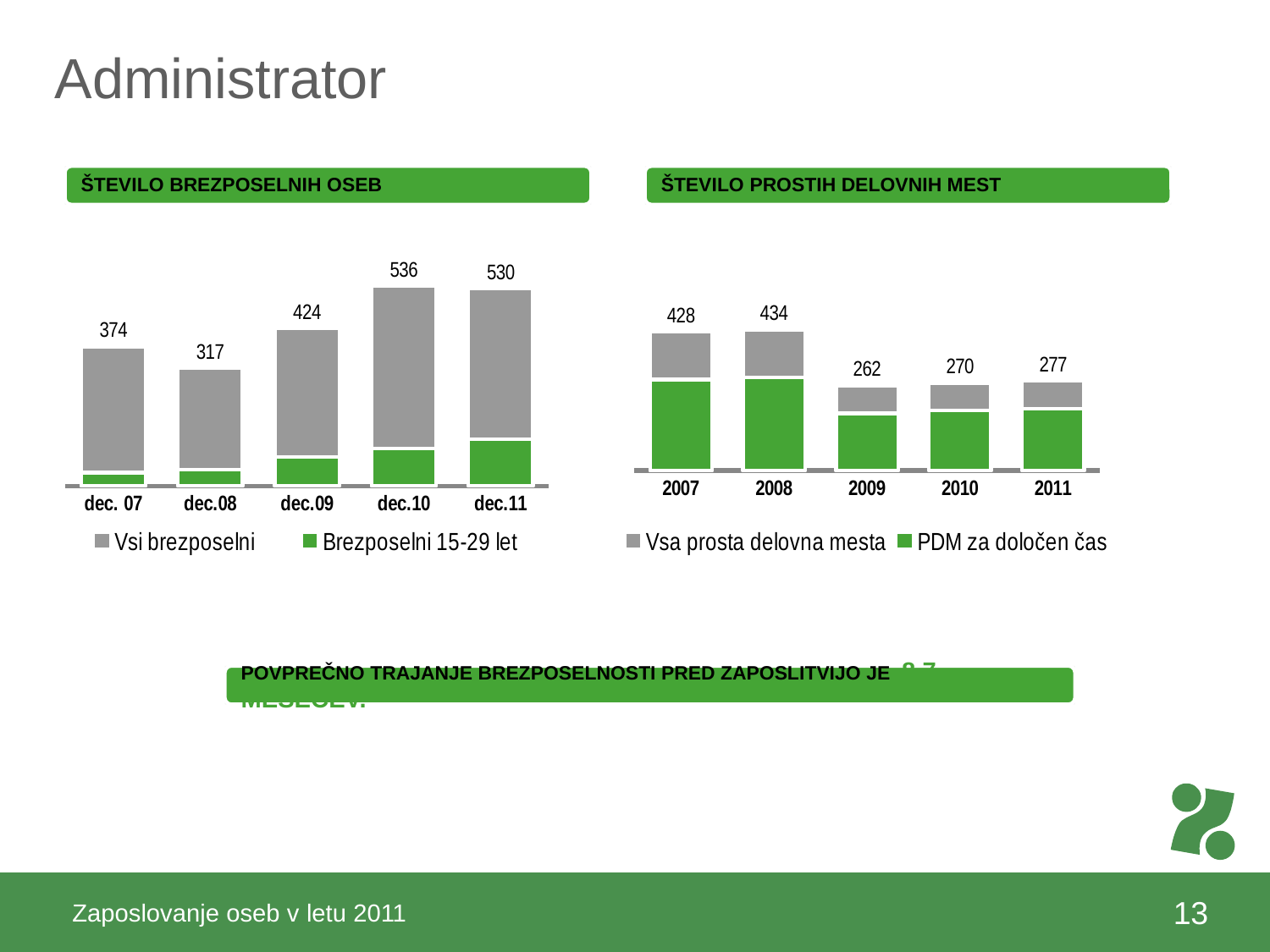
In the chart titled ŠTEVILO BREZPOSELNIH OSEB, what value is labelled for dec.10? 536 In the chart titled ŠTEVILO PROSTIH DELOVNIH MEST, which year has the lowest labelled value? 2009 In the chart titled ŠTEVILO PROSTIH DELOVNIH MEST, what value is labelled for 2008? 434 In the chart titled ŠTEVILO BREZPOSELNIH OSEB, what is the difference between the labelled values for dec.10 and dec.11? 6 In the chart titled ŠTEVILO BREZPOSELNIH OSEB, how many series does the legend list? 2 In the chart titled ŠTEVILO PROSTIH DELOVNIH MEST, how many years are shown on the x axis? 5 In the chart titled ŠTEVILO PROSTIH DELOVNIH MEST, what is the difference between the labelled values for 2007 and 2011? 151 In the chart titled ŠTEVILO BREZPOSELNIH OSEB, what value is labelled for dec.08? 317 In the chart titled ŠTEVILO BREZPOSELNIH OSEB, which period has the highest labelled value? dec.10 In the chart titled ŠTEVILO BREZPOSELNIH OSEB, which period has the lowest labelled value? dec.08 In the chart titled ŠTEVILO PROSTIH DELOVNIH MEST, what value is labelled for 2009? 262 What kind of chart is the chart titled ŠTEVILO PROSTIH DELOVNIH MEST? Bar chart